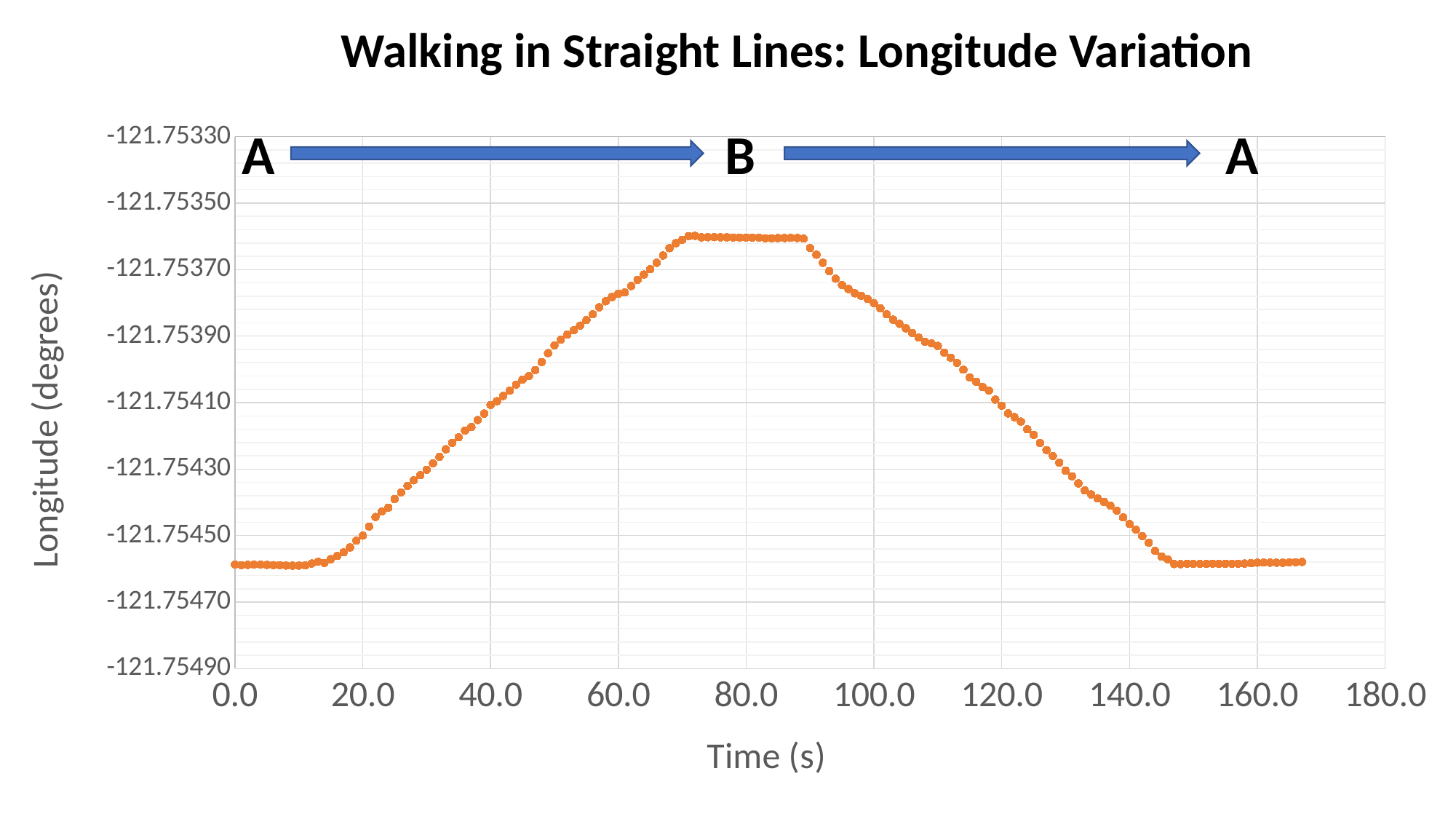
Is the longitude at 40 s greater or less than -121.75390? less Between 20 s and 60 s, does the longitude rise or fall as time increases? rise Between 100 s and 140 s, does the longitude rise or fall as time increases? fall Is the longitude at 160 s greater or less than -121.75450? less Is the longitude at 0 s greater or less than -121.75450? less Which is larger, the longitude at 80 s or the longitude at 20 s? the longitude at 80 s What is the highest tick value shown on the time axis? 180.0 What is the title of the chart? Walking in Straight Lines: Longitude Variation Which is larger, the longitude at 120 s or the longitude at 160 s? the longitude at 120 s What kind of chart is shown on the slide? scatter chart What is the label of the vertical axis? Longitude (degrees)